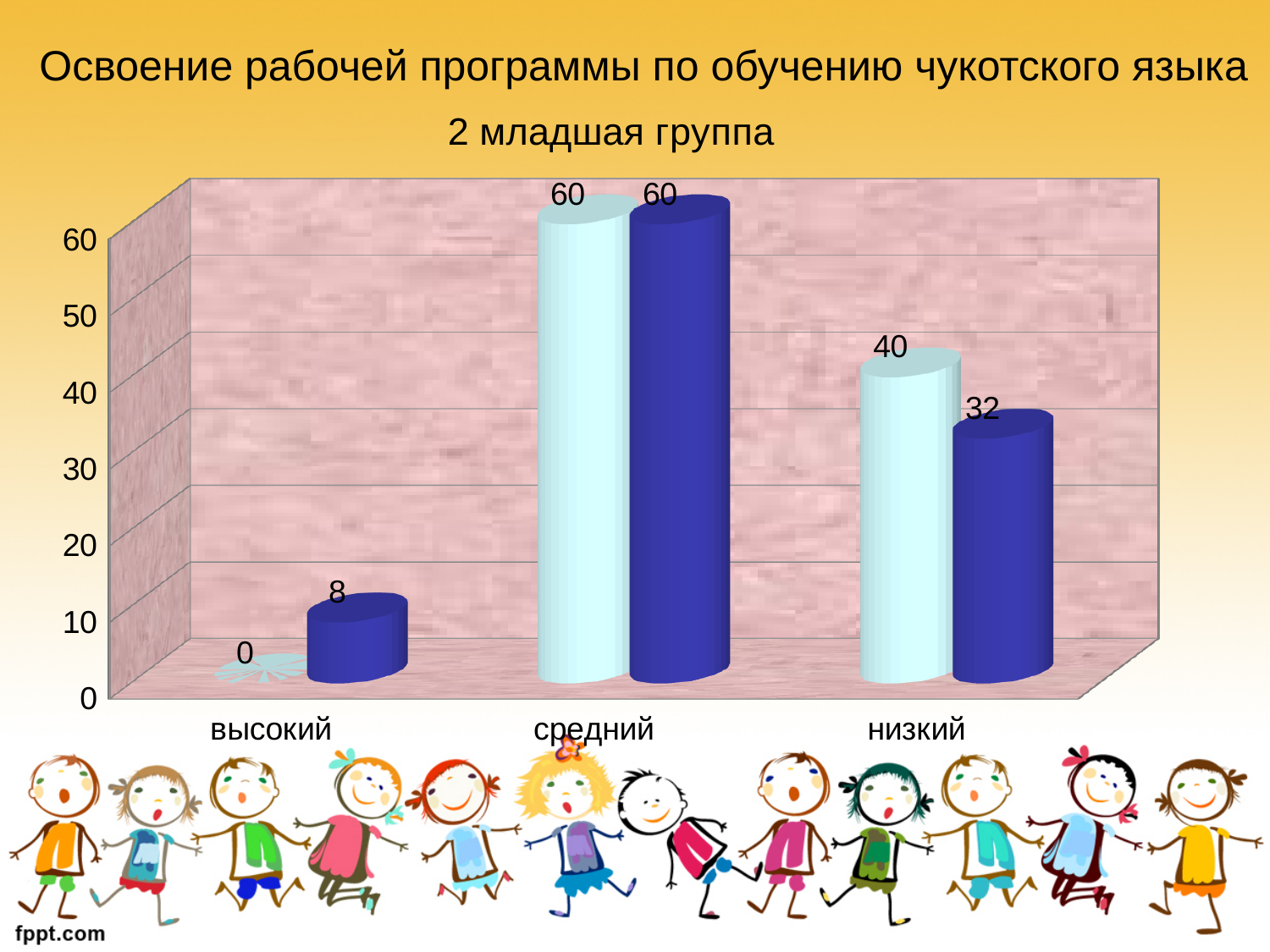
What is the value of the dark blue bar for the category 'высокий'? 8 What is the subtitle shown above the chart, below the main title? 2 младшая группа For the category 'низкий', which bar is larger, the light blue or the dark blue? light blue What type of chart is shown on the slide? bar chart What is the value of the dark blue bar for the category 'низкий'? 32 Which category has the lowest value for the light blue bars? высокий What is the value of the light blue bar for the category 'низкий'? 40 What is the difference between the light blue and dark blue bars for the category 'низкий'? 8 How many categories are shown on the x axis of the chart? 3 Which category has the highest value for the dark blue bars? средний What is the value of the light blue bar for the category 'средний'? 60 What is the value of the light blue bar for the category 'высокий'? 0